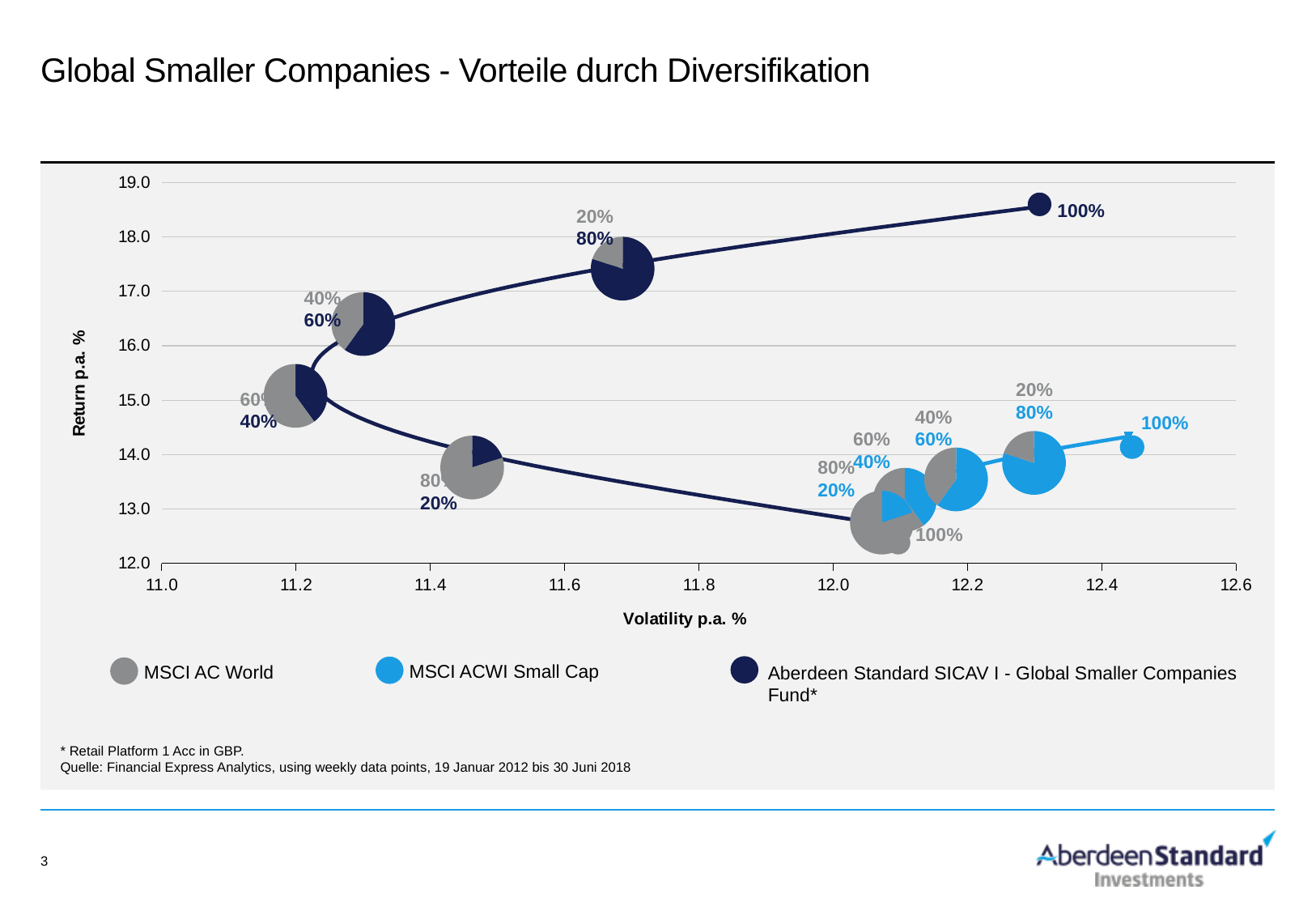
Is the return for the 100% Aberdeen Standard SICAV I - Global Smaller Companies Fund point greater or less than 18.0? greater What kind of chart is shown on the slide? Scatter (bubble) chart What is the title of the y axis? Return p.a. % Which 100% point has the lowest return: MSCI AC World, MSCI ACWI Small Cap, or the Aberdeen Standard SICAV I - Global Smaller Companies Fund? MSCI AC World Is the return for the 100% MSCI AC World point greater or less than 13.0? less Which 100% point has the highest return: MSCI AC World, MSCI ACWI Small Cap, or the Aberdeen Standard SICAV I - Global Smaller Companies Fund? Aberdeen Standard SICAV I - Global Smaller Companies Fund Is the volatility for the 100% MSCI AC World point greater or less than 12.0? greater How many series does the legend list? 3 Along the upper curve (MSCI AC World to the Aberdeen Standard fund), does return rise or fall as volatility increases? rise Which has the higher return: the 100% MSCI ACWI Small Cap point or the 100% MSCI AC World point? 100% MSCI ACWI Small Cap What is the title of the x axis? Volatility p.a. %